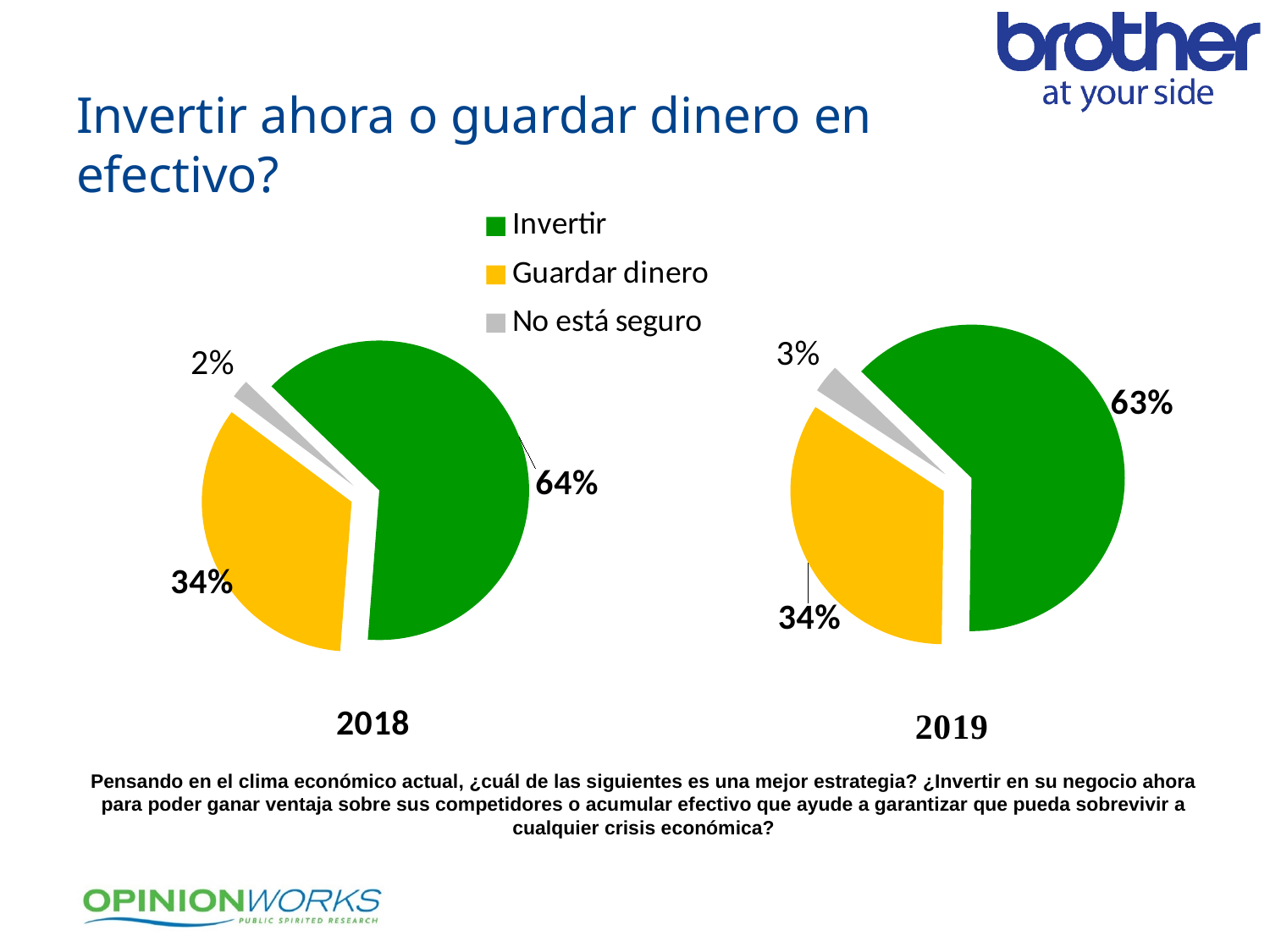
In the 2019 pie chart, what percentage is shown for No está seguro? 3% What type of chart is used to show the 2018 data? Pie chart What is the difference in percentage points between Invertir and Guardar dinero in the 2018 pie chart? 30 How many slices does the 2019 pie chart have? 3 In the 2019 pie chart, which category has the largest slice? Invertir In the 2019 pie chart, what share of respondents chose Guardar dinero? 34% In the 2018 pie chart, which category has the smallest slice? No está seguro In the 2018 pie chart, what share of respondents chose Invertir? 64% In the 2018 pie chart, what percentage is shown for No está seguro? 2% Is the Invertir share larger in the 2018 pie chart or the 2019 pie chart? 2018 How many entries does the legend list? 3 Which colour represents Guardar dinero in the legend? Yellow